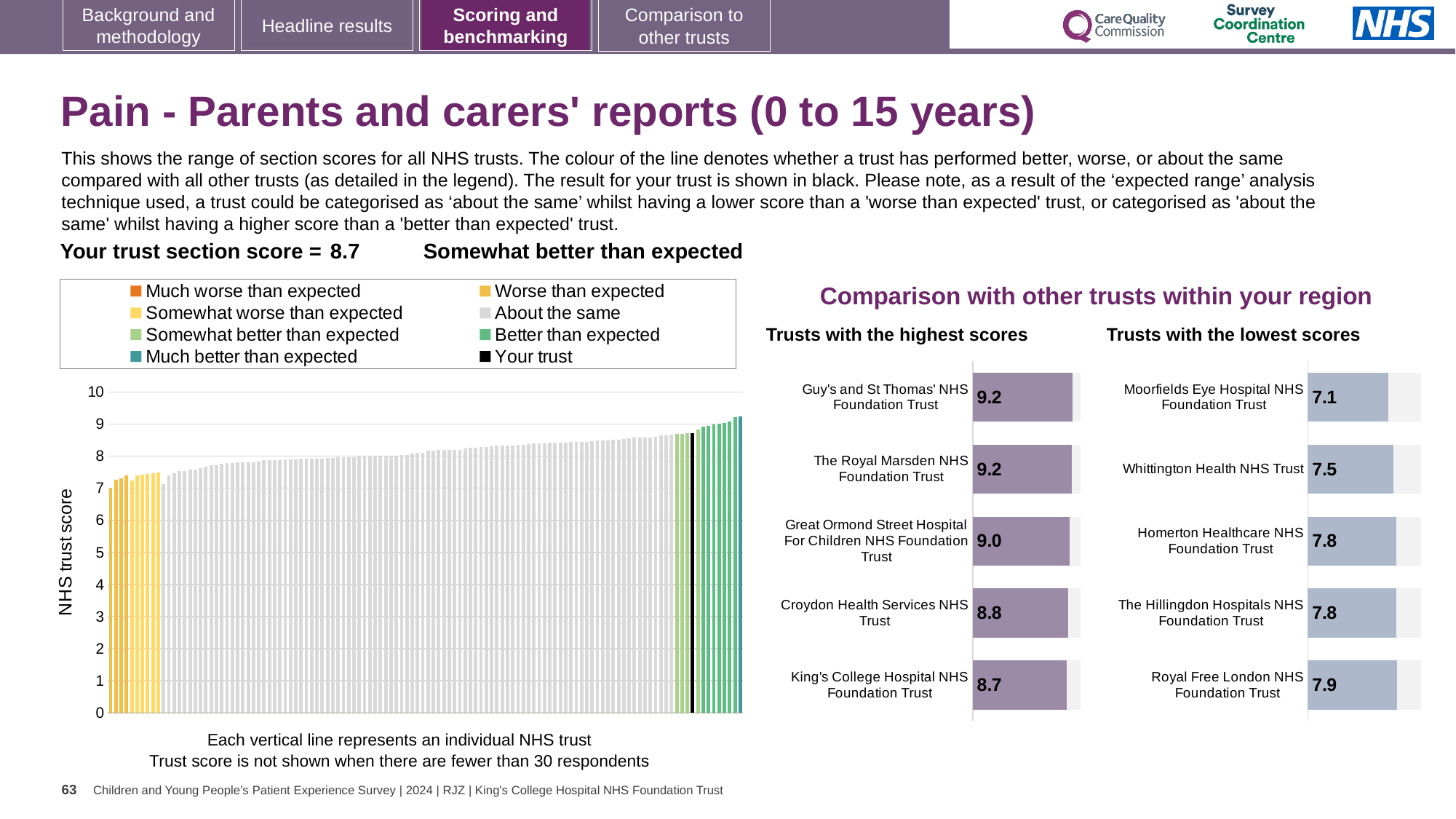
On the 'Trusts with the lowest scores' chart, what is the difference between the scores of Royal Free London NHS Foundation Trust and Moorfields Eye Hospital NHS Foundation Trust? 0.8 On the 'Trusts with the highest scores' chart, what is the difference between the scores of Guy's and St Thomas' NHS Foundation Trust and King's College Hospital NHS Foundation Trust? 0.5 On the 'Trusts with the lowest scores' chart, what is the score for Whittington Health NHS Trust? 7.5 On the large chart on the left showing the range of section scores, what kind of chart is it? Bar chart On the large chart on the left showing the range of section scores, how many entries does the legend list? 8 On the 'Trusts with the highest scores' chart, what is the score for Great Ormond Street Hospital For Children NHS Foundation Trust? 9.0 On the 'Trusts with the highest scores' chart, how many trusts are shown? 5 On the 'Trusts with the lowest scores' chart, which has the larger score: Whittington Health NHS Trust or Homerton Healthcare NHS Foundation Trust? Homerton Healthcare NHS Foundation Trust On the 'Trusts with the lowest scores' chart, which trust has the lowest score? Moorfields Eye Hospital NHS Foundation Trust On the 'Trusts with the highest scores' chart, which trust has the lowest score? King's College Hospital NHS Foundation Trust On the 'Trusts with the lowest scores' chart, which trust has the highest score? Royal Free London NHS Foundation Trust On the large chart on the left showing the range of section scores, do the values rise or fall from left to right? Rise